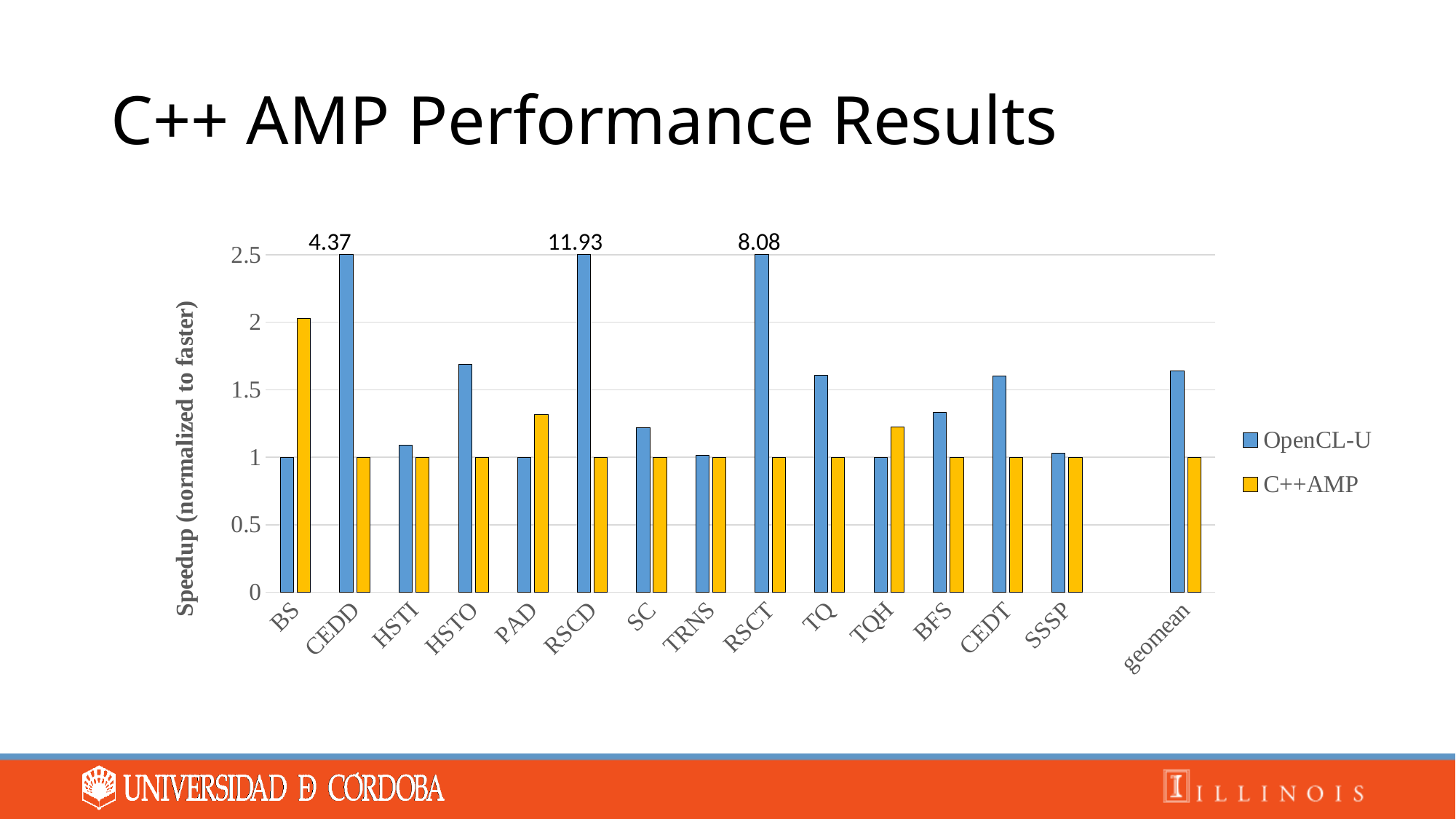
How many categories are shown on the x axis? 15 What is the label of the y axis? Speedup (normalized to faster) Is the OpenCL-U value for geomean greater or less than 1.5? greater What is the difference between the OpenCL-U values for RSCD and RSCT? 3.85 What is the OpenCL-U speedup value labeled for RSCD? 11.93 What is the OpenCL-U speedup value labeled for CEDD? 4.37 Is the C++AMP value for BS greater or less than 1.5? greater What type of chart is shown on the slide? bar chart For BS, which series has the larger value, OpenCL-U or C++AMP? C++AMP Which category has the highest OpenCL-U value? RSCD How many series does the legend list? 2 What is the OpenCL-U speedup value labeled for RSCT? 8.08